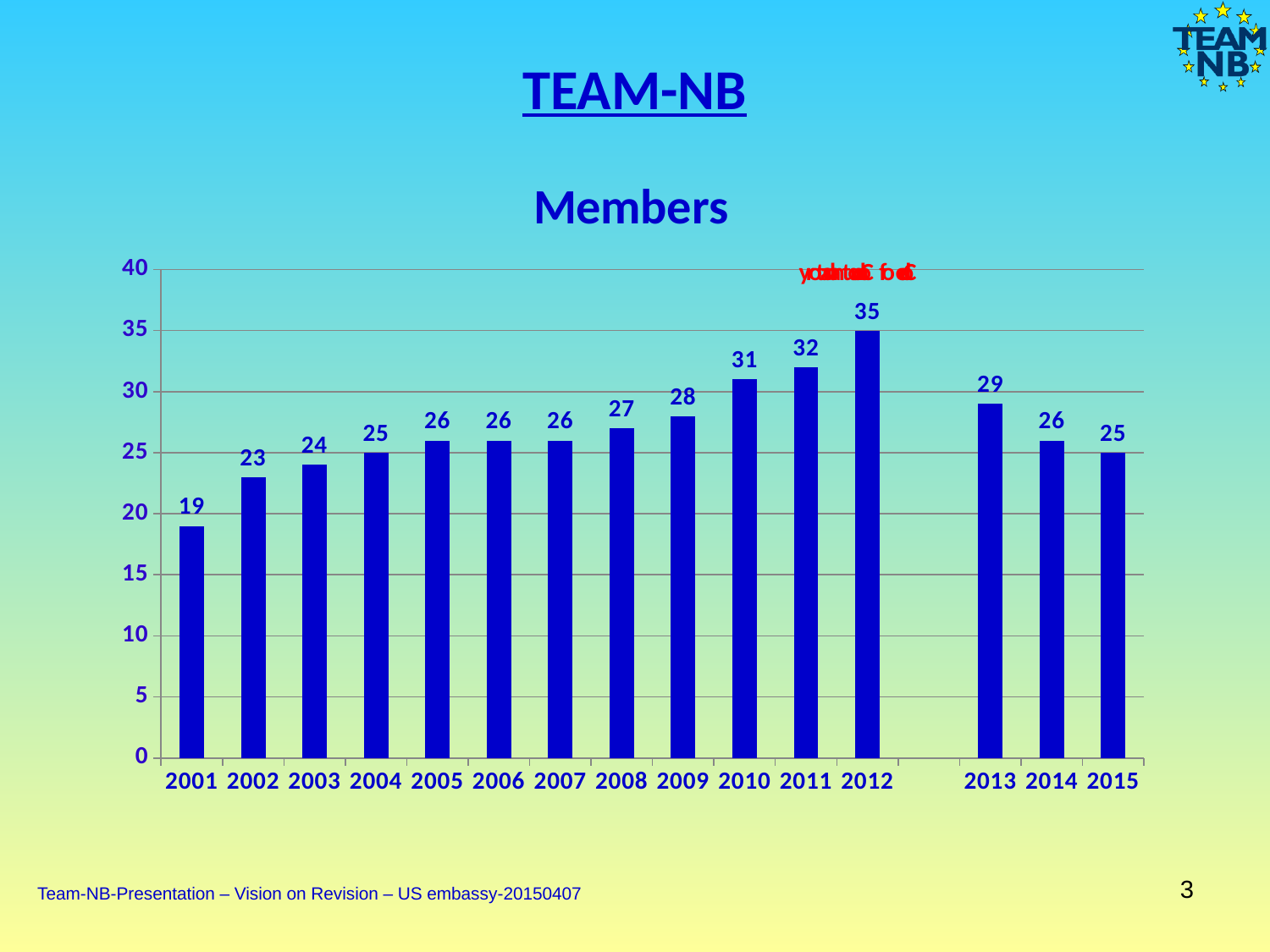
What is the difference between the values for 2011 and 2001 in the Members chart? 13 What is the value for 2013 in the Members chart? 29 What is the value for 2001 in the Members chart? 19 What is the value for 2015 in the Members chart? 25 What is the difference between the values for 2012 and 2013 in the Members chart? 6 Do the values in the Members chart rise or fall from 2001 to 2012? Rise What kind of chart is the Members chart? Bar chart Which is larger in the Members chart, the value for 2010 or the value for 2014? 2010 How many years are labeled on the x axis of the Members chart? 15 Which year has the highest value in the Members chart? 2012 What is the value for 2012 in the Members chart? 35 Which year has the lowest value in the Members chart? 2001